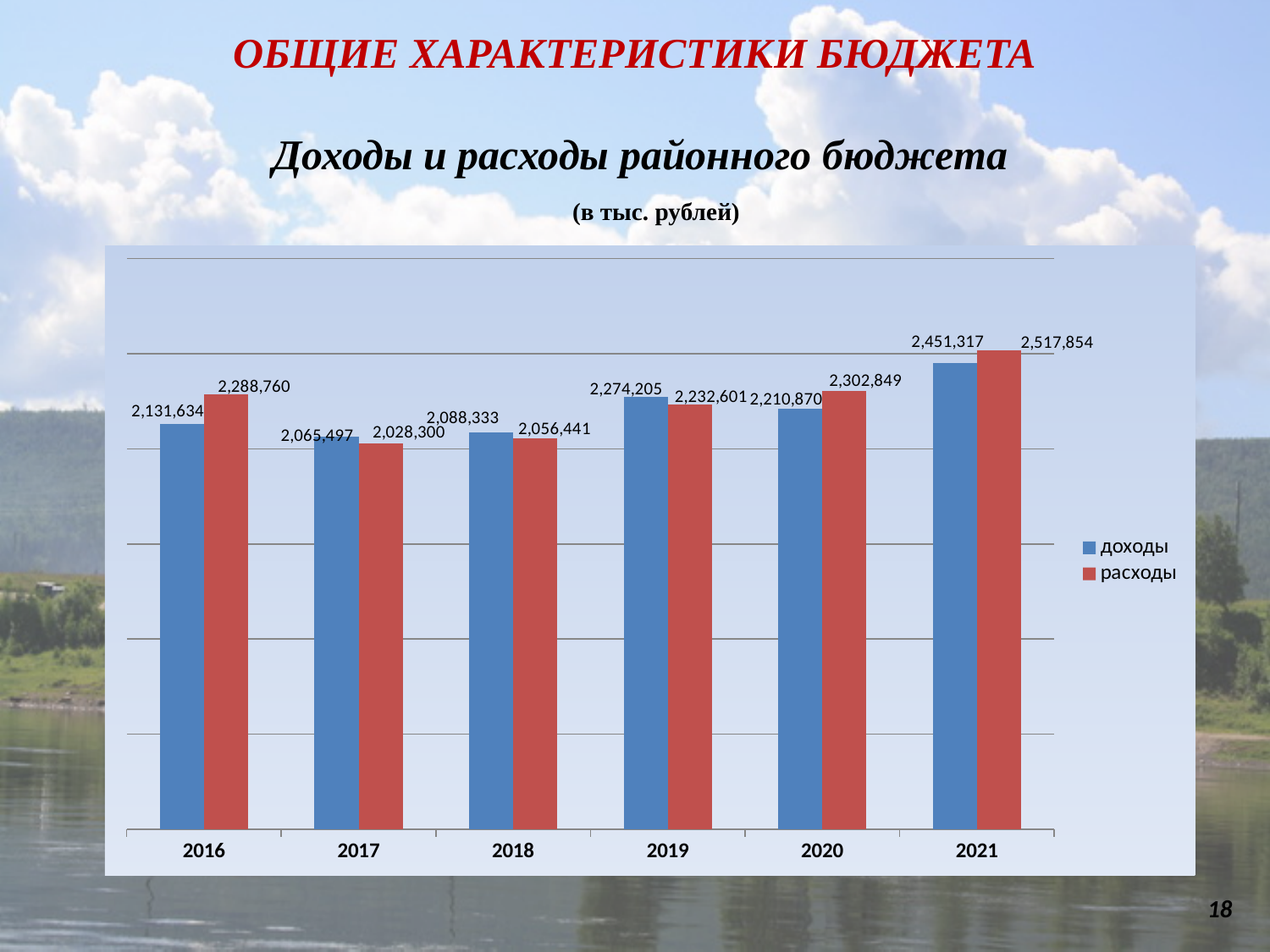
What is the difference between расходы and доходы in 2021? 66,537 In 2019, which is larger: доходы or расходы? доходы How many series does the legend list? 2 What kind of chart is shown on the slide? bar chart What is the value of расходы for 2018? 2,056,441 What is the difference between расходы and доходы in 2016? 157,126 In which year are расходы the lowest? 2017 What is the value of доходы for 2016? 2,131,634 In which year are доходы the highest? 2021 How many years are shown on the x axis? 6 What is the value of расходы for 2021? 2,517,854 Do расходы rise or fall from 2018 to 2021? rise